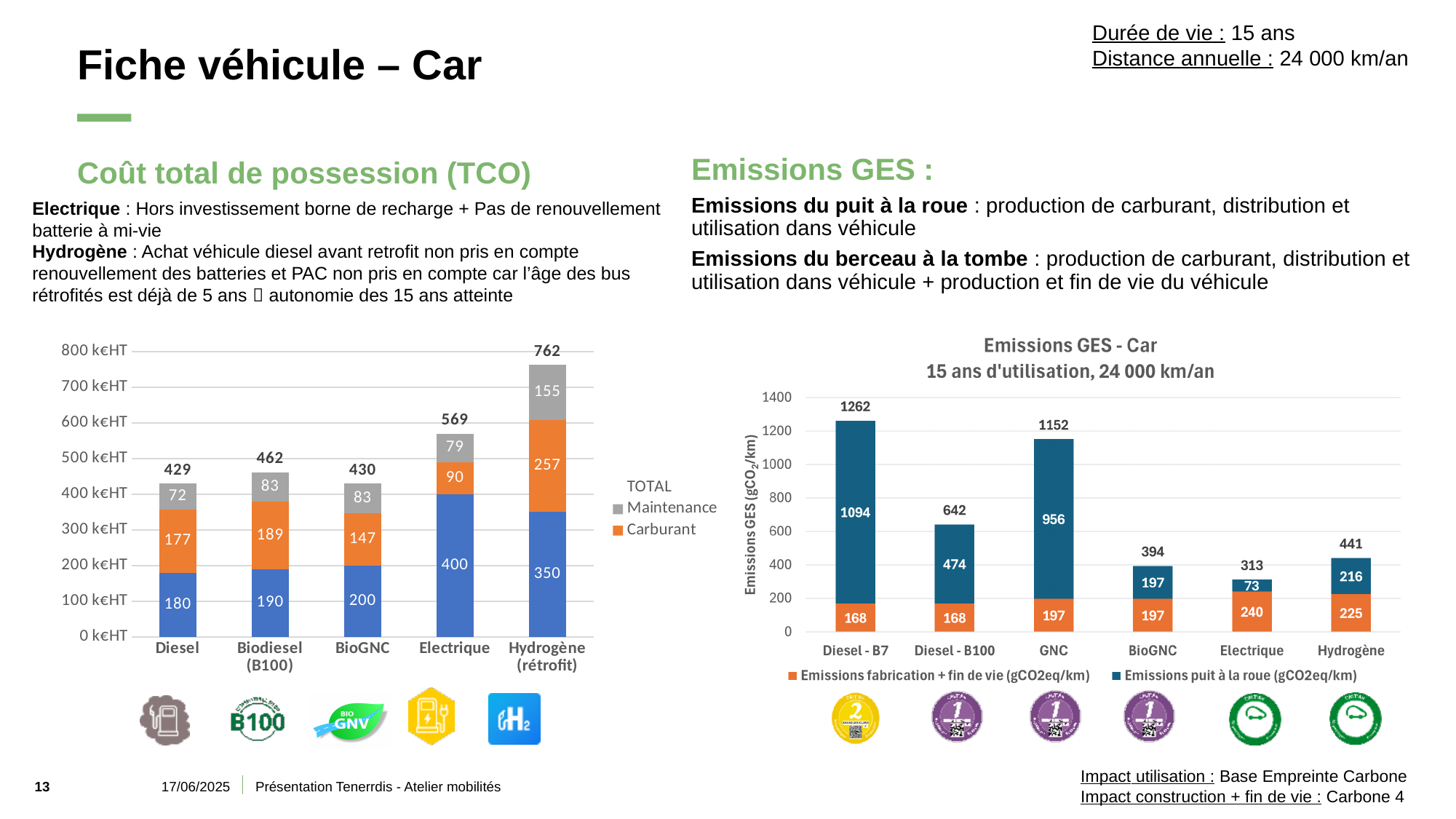
In the 'Emissions GES - Car' chart, what is the difference between the totals for Diesel - B7 and Diesel - B100? 620 In the TCO chart on the left, what is the total shown above the bar for Hydrogène (rétrofit)? 762 In the TCO chart on the left, what is the Carburant value for Biodiesel (B100)? 189 In the TCO chart on the left, what is the difference between the totals for Electrique and Diesel? 140 In the TCO chart on the left, is the Maintenance value larger for Electrique or for Hydrogène (rétrofit)? Hydrogène (rétrofit) In the 'Emissions GES - Car' chart, how many series does the legend list? 2 In the 'Emissions GES - Car' chart, what is the 'Emissions puit à la roue' value for GNC? 956 In the TCO chart on the left, which category has the highest total? Hydrogène (rétrofit) In the 'Emissions GES - Car' chart, how many categories are shown on the x axis? 6 In the 'Emissions GES - Car' chart, which category has the lowest total? Electrique What kind of chart is the TCO chart on the left? Stacked bar chart In the 'Emissions GES - Car' chart, what is the total value shown above the bar for Diesel - B7? 1262